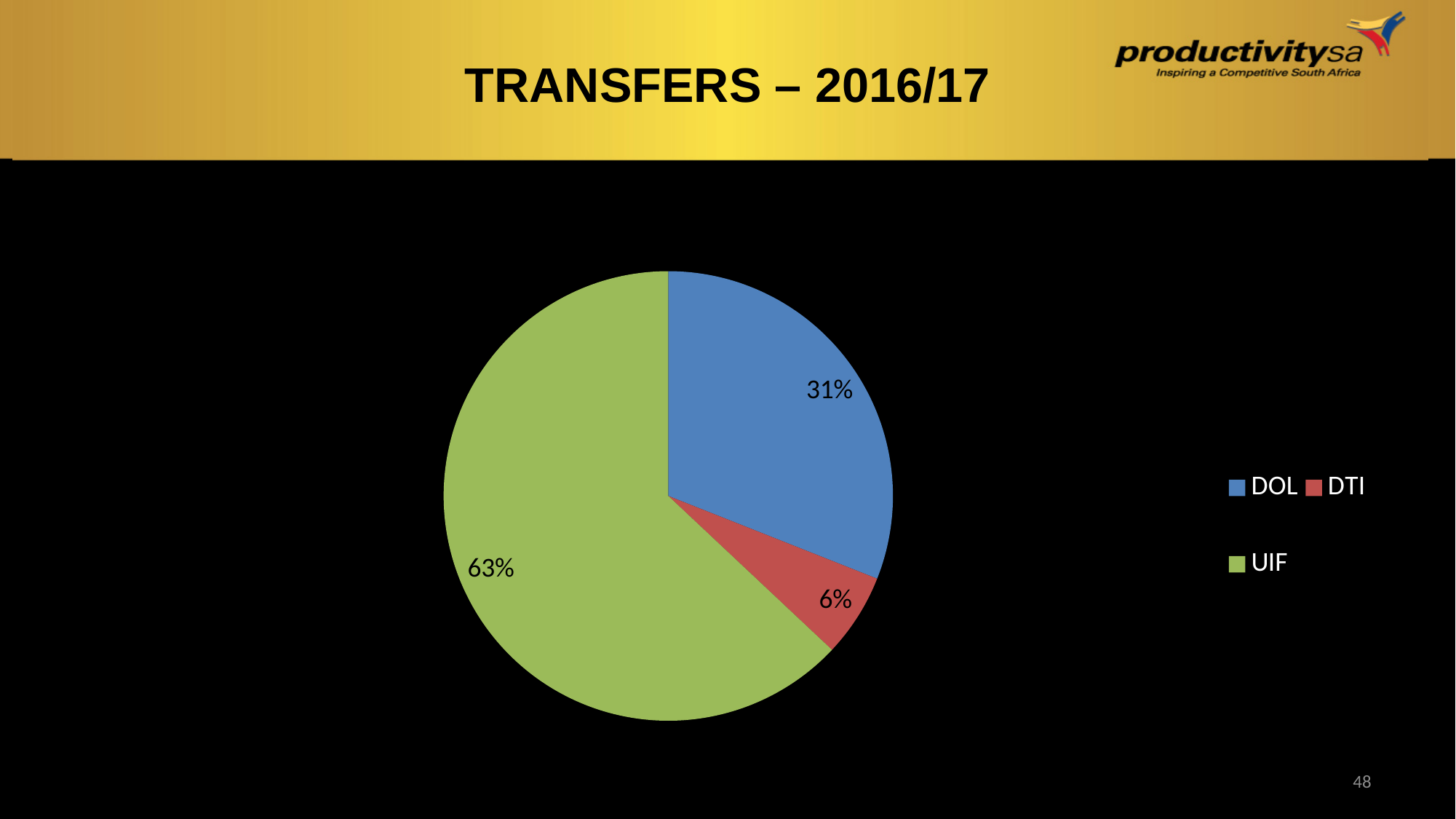
Which category has the smallest slice of the pie? DTI Which category has the largest slice of the pie? UIF What is the difference in percentage points between the UIF share and the DOL share? 32 What is the difference in percentage points between the DOL share and the DTI share? 25 What share of transfers does DOL account for? 31% Which is larger, the share for DOL or the share for DTI? DOL How many categories are shown in the pie chart? 3 What is the title of the slide containing the chart? TRANSFERS – 2016/17 What share of transfers does DTI account for? 6% What kind of chart is shown on the slide? pie chart What share of transfers does UIF account for? 63% What colour is the UIF slice in the pie chart? green